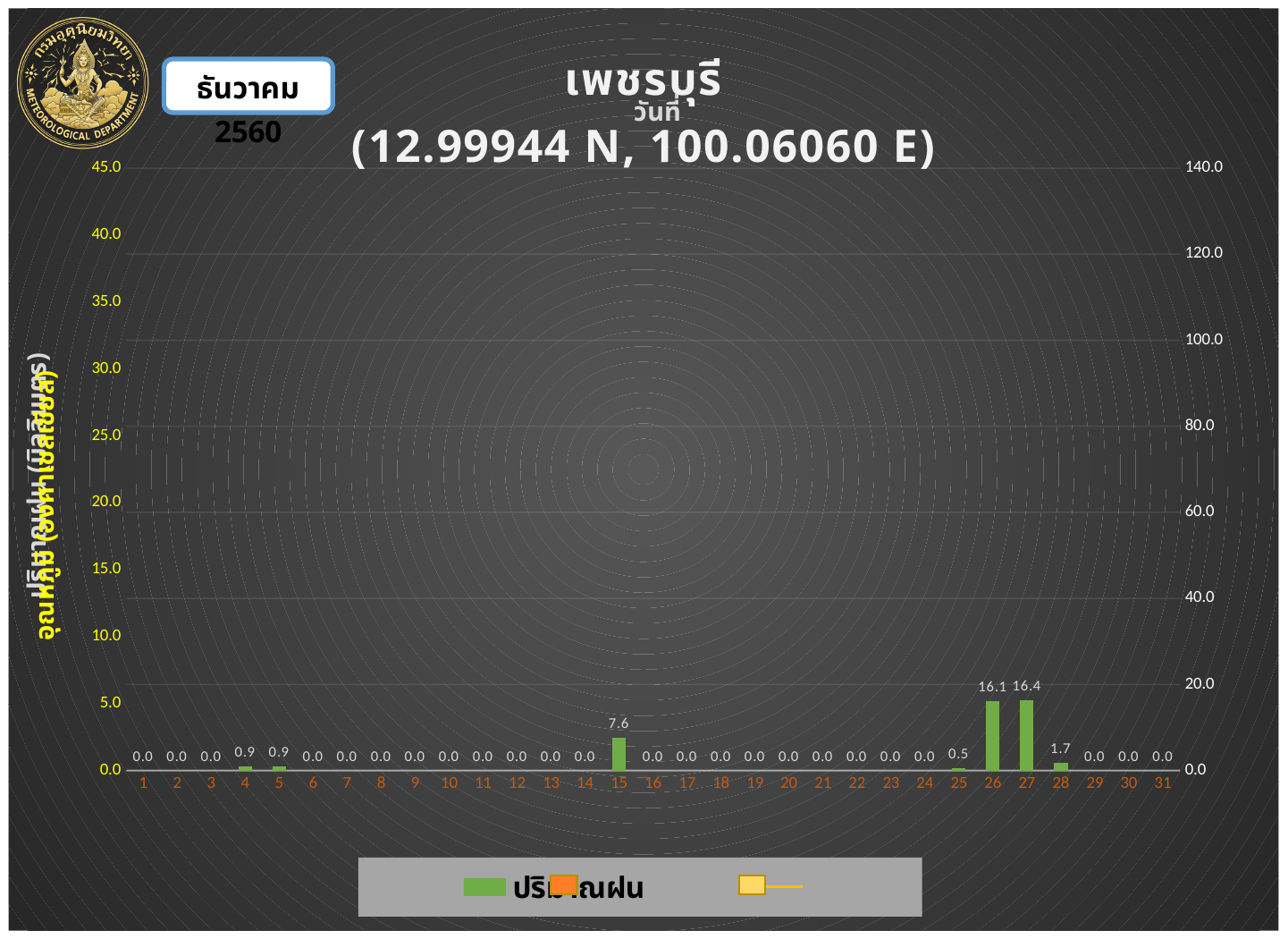
What is the rainfall value shown for day 26? 16.1 What is the rainfall value shown for day 25? 0.5 How many days are shown on the x axis? 31 What is the rainfall value shown for day 28? 1.7 What is the rainfall value shown for day 15? 7.6 Which is larger, the rainfall value for day 15 or for day 28? day 15 What is the difference between the rainfall values for day 26 and day 15? 8.5 What is the rainfall value shown for day 4? 0.9 What is the difference between the rainfall values for day 27 and day 26? 0.3 What are the coordinates shown in the chart title? 12.99944 N, 100.06060 E Which day has the highest rainfall value? 27 What kind of chart is used to show the rainfall values? bar chart